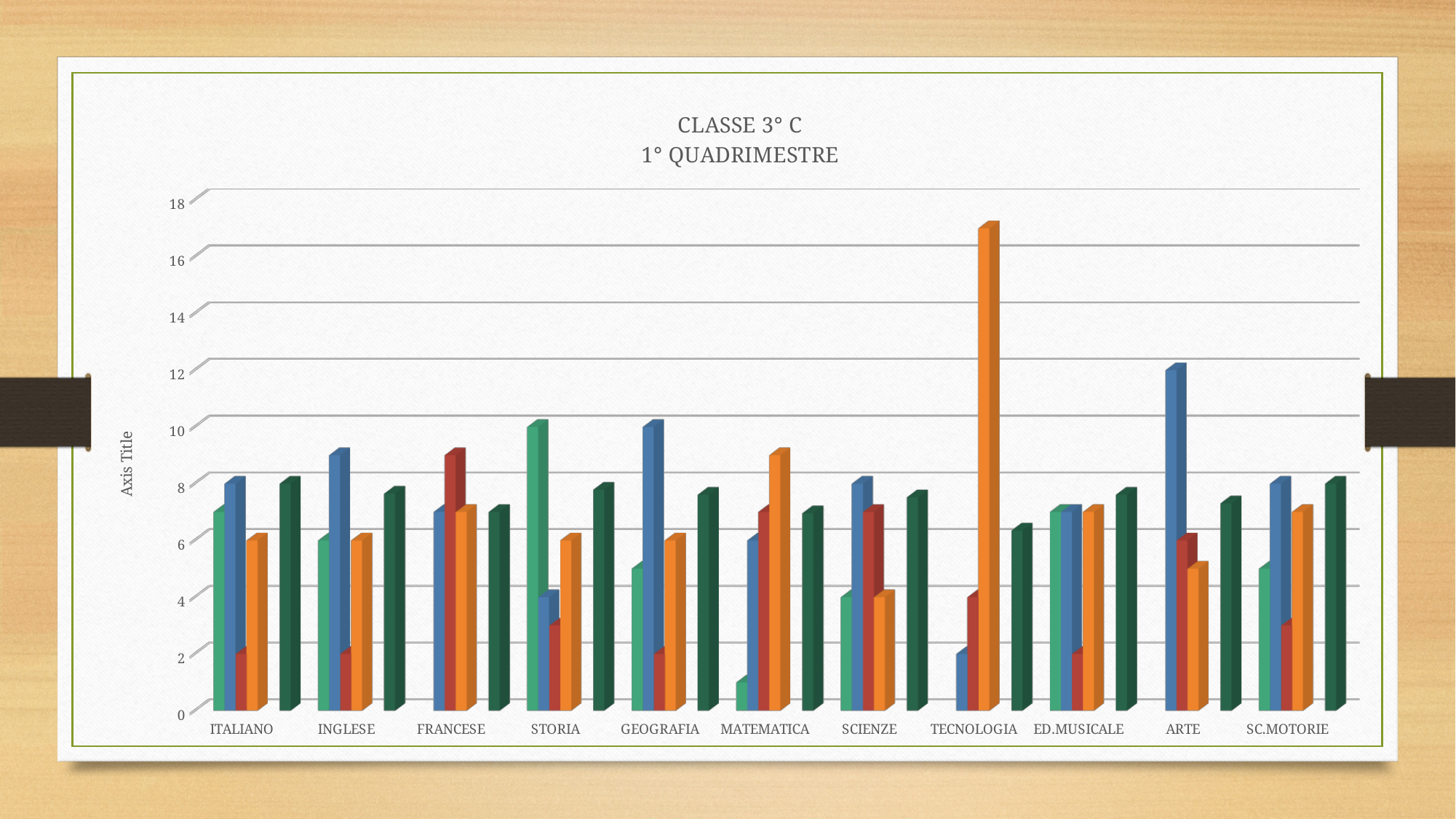
How many subject categories are shown on the x axis? 11 Is the blue bar for ARTE greater or less than 10? greater What label is shown on the vertical axis? Axis Title Which is taller, the blue bar for ARTE or the blue bar for INGLESE? ARTE What kind of chart is shown on the slide? bar chart Which category has the tallest blue bar? ARTE Which category contains the tallest bar in the chart? TECNOLOGIA Is the orange bar for TECNOLOGIA greater or less than 16? greater What is the title of the chart? CLASSE 3° C 1° QUADRIMESTRE Is the blue bar for TECNOLOGIA greater or less than 4? less Which category has the shortest light green bar? MATEMATICA